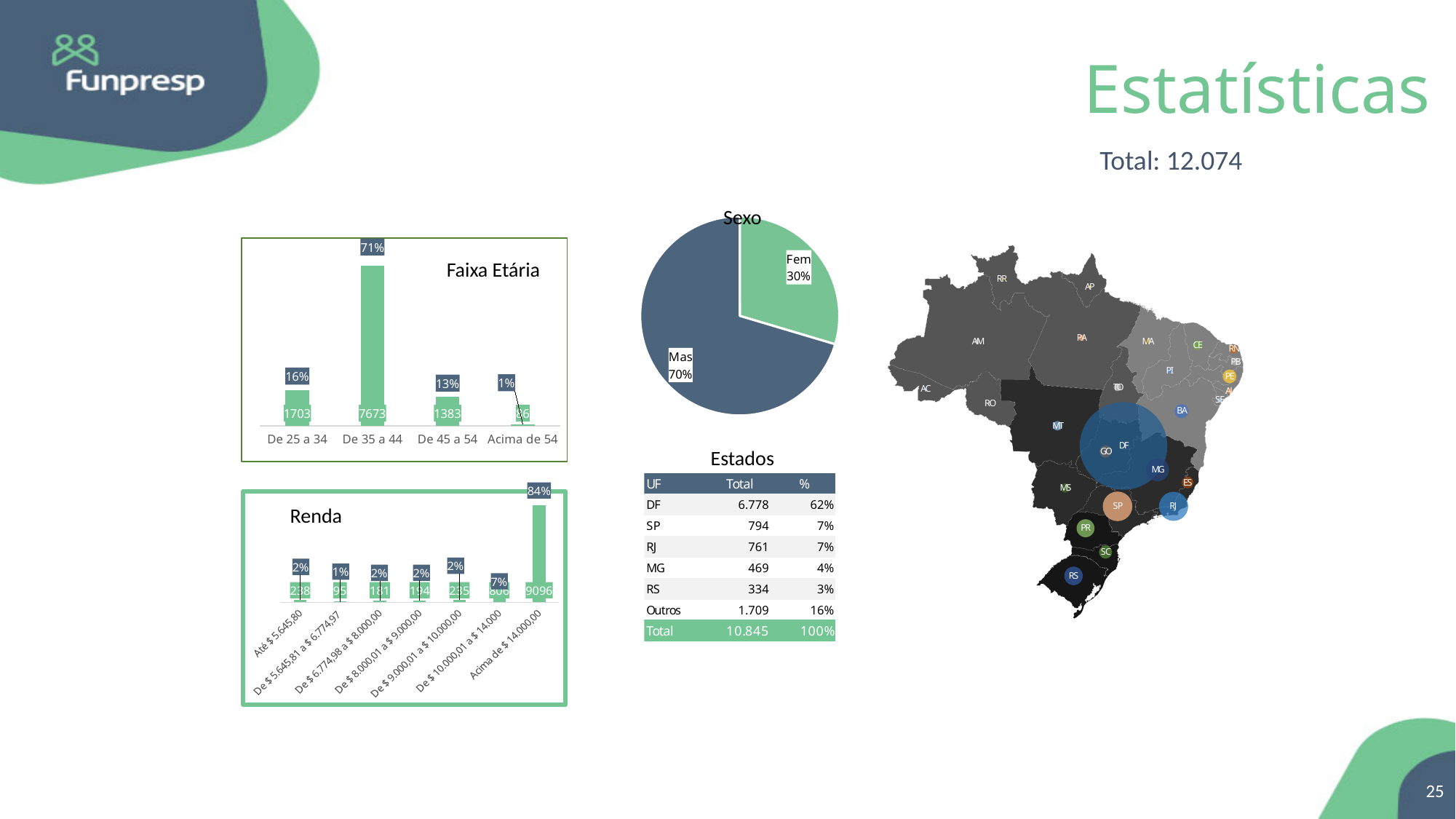
How many age categories are shown in the Faixa Etária chart? 4 In the Faixa Etária chart, which age category has the highest value? De 35 a 44 In the Renda chart, what percentage is shown for the Acima de $ 14.000,00 category? 84% In the Faixa Etária chart, what percentage is shown for the De 35 a 44 category? 71% In the Sexo pie chart, what share is shown for Fem? 30% How many income categories are shown in the Renda chart? 7 What type of chart is the Sexo chart? Pie chart In the Faixa Etária chart, what is the difference in percentage points between De 25 a 34 and De 45 a 54? 3 In the Renda chart, what count is shown for the De $ 6.774,98 a $ 8.000,00 category? 181 In the Faixa Etária chart, what count is shown for the De 25 a 34 category? 1703 In the Renda chart, which income category has the highest value? Acima de $ 14.000,00 In the Faixa Etária chart, which age category has the lowest value? Acima de 54